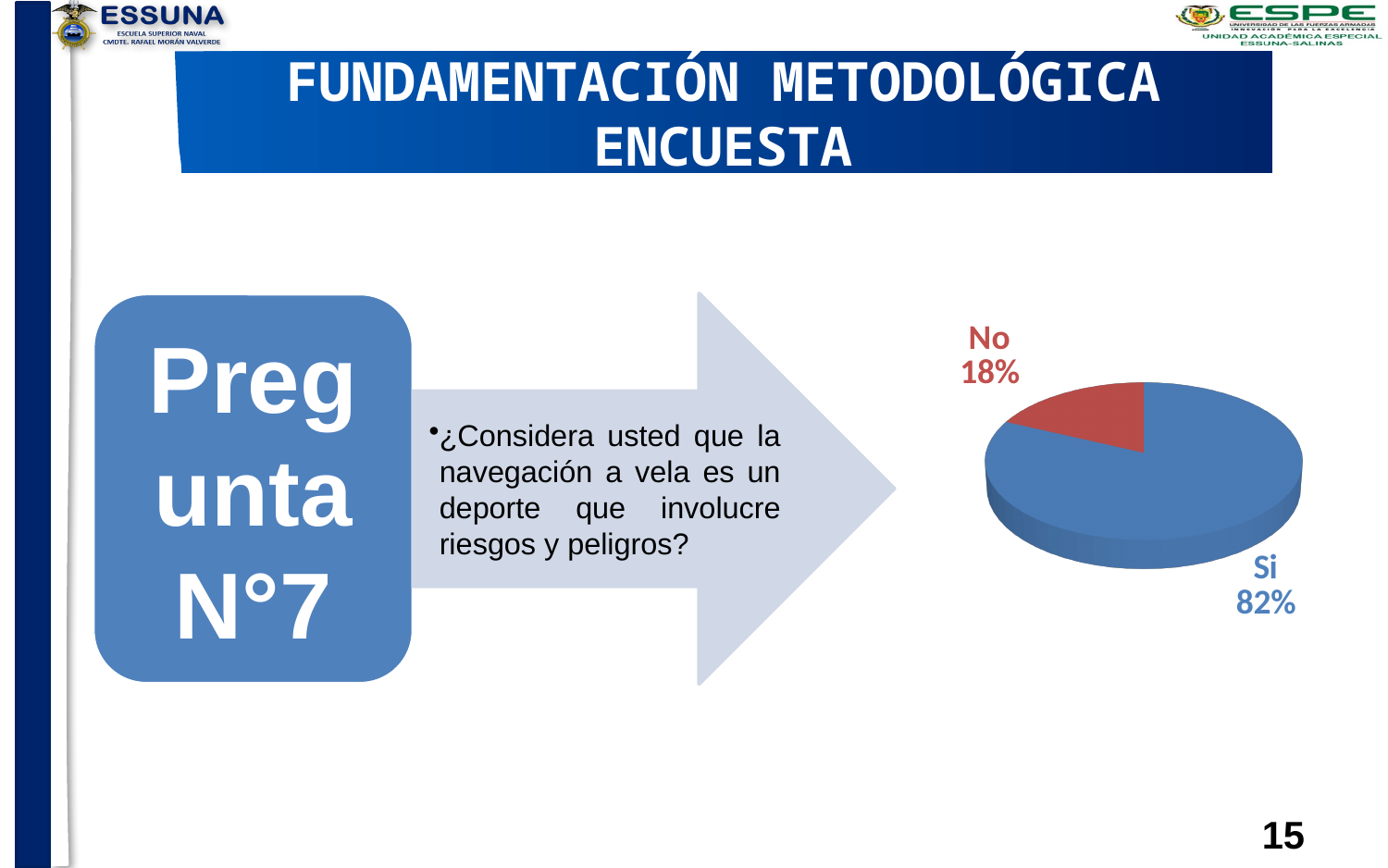
What percentage of respondents answered "Si"? 82% What colour is the "Si" slice of the pie chart? blue How many slices does the pie chart have? 2 Which response has the smallest share of the pie? No Which response has the largest share of the pie? Si Which is larger, the "Si" slice or the "No" slice? Si What colour is the "No" slice of the pie chart? red What is the difference in percentage points between the "Si" and "No" slices? 64 What share of the pie does the "No" slice represent? 18% What percentage of respondents answered "No"? 18% What kind of chart is shown on the slide? pie chart